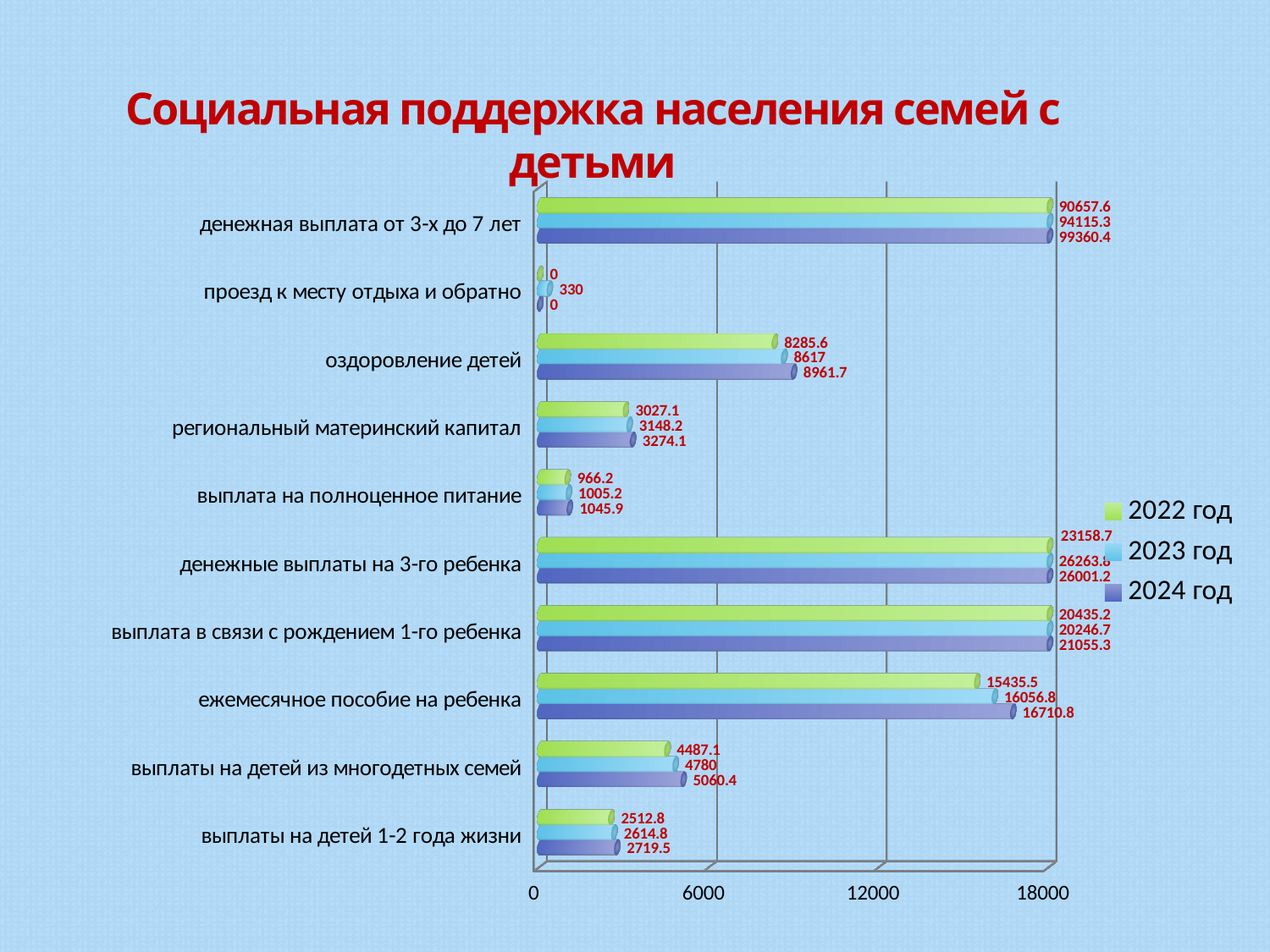
What is the 2024 год value for оздоровление детей? 8961.7 How many series does the legend list? 3 What is the 2023 год value for проезд к месту отдыха и обратно? 330 What is the 2022 год value for ежемесячное пособие на ребенка? 15435.5 What is the difference between the 2024 год and 2022 год values for выплаты на детей из многодетных семей? 573.3 For выплата в связи с рождением 1-го ребенка, which is larger: the 2022 год value or the 2023 год value? 2022 год Which category has the highest 2024 год value? денежная выплата от 3-х до 7 лет How many categories are shown on the chart? 10 What kind of chart is shown on the slide? bar chart What is the title of the chart? Социальная поддержка населения семей с детьми Which category has the lowest 2023 год value? проезд к месту отдыха и обратно What is the difference between the 2024 год and 2023 год values for региональный материнский капитал? 125.9